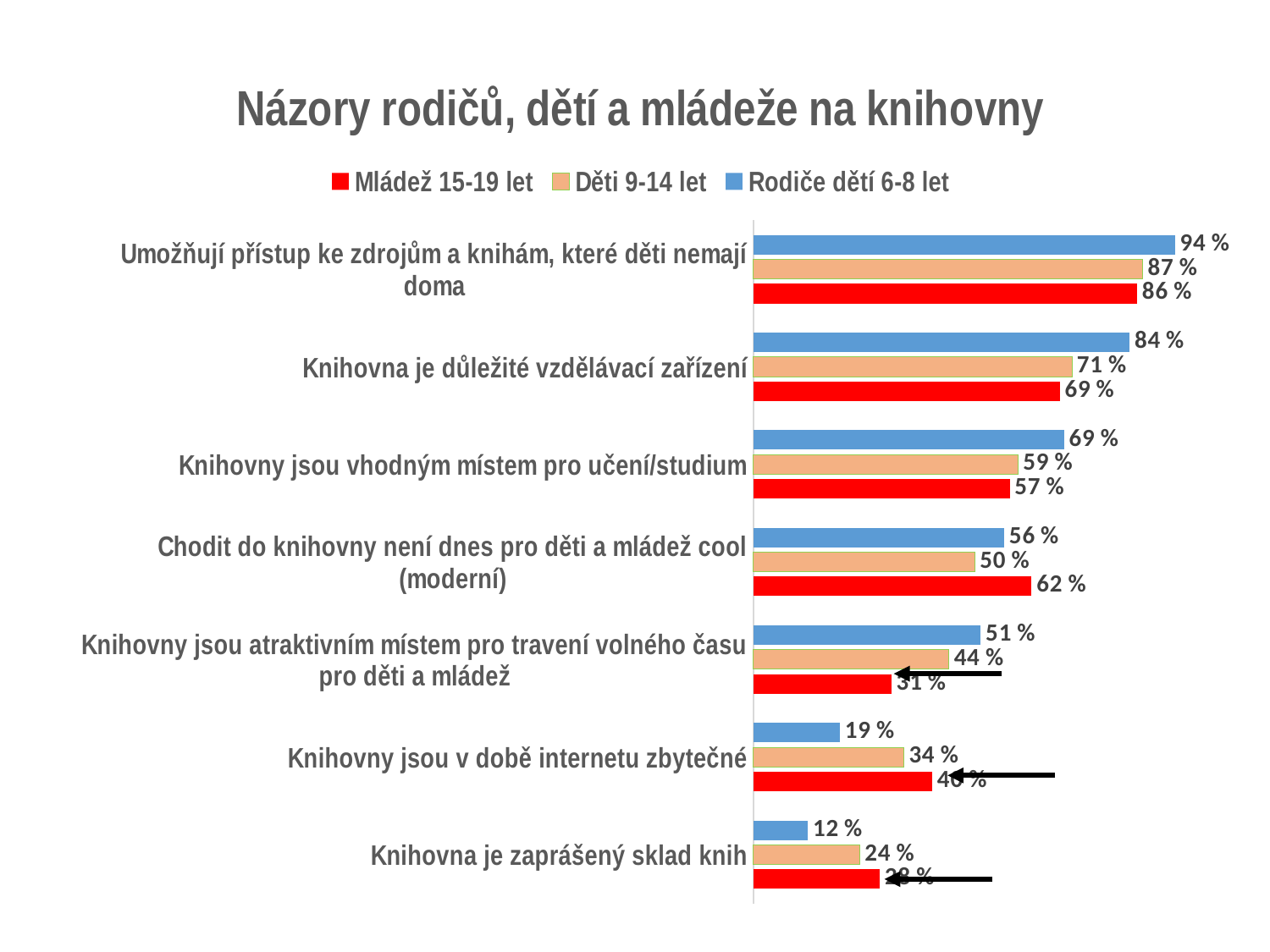
What is the value for Rodiče dětí 6-8 let for 'Knihovna je zaprášený sklad knih'? 12 % For 'Knihovny jsou vhodným místem pro učení/studium', which is larger: the value for Rodiče dětí 6-8 let or for Mládež 15-19 let? Rodiče dětí 6-8 let What is the value for Mládež 15-19 let for 'Chodit do knihovny není dnes pro děti a mládež cool (moderní)'? 62 % Which statement has the lowest value for Děti 9-14 let? Knihovna je zaprášený sklad knih What is the title of the chart? Názory rodičů, dětí a mládeže na knihovny What is the value for Rodiče dětí 6-8 let for 'Umožňují přístup ke zdrojům a knihám, které děti nemají doma'? 94 % Which statement has the highest value for Rodiče dětí 6-8 let? Umožňují přístup ke zdrojům a knihám, které děti nemají doma What is the difference between Rodiče dětí 6-8 let and Děti 9-14 let for 'Knihovny jsou v době internetu zbytečné'? 15 % How many categories (statements) are shown on the chart? 7 What type of chart is shown on the slide? bar chart How many series does the legend list? 3 What is the value for Děti 9-14 let for 'Knihovna je důležité vzdělávací zařízení'? 71 %